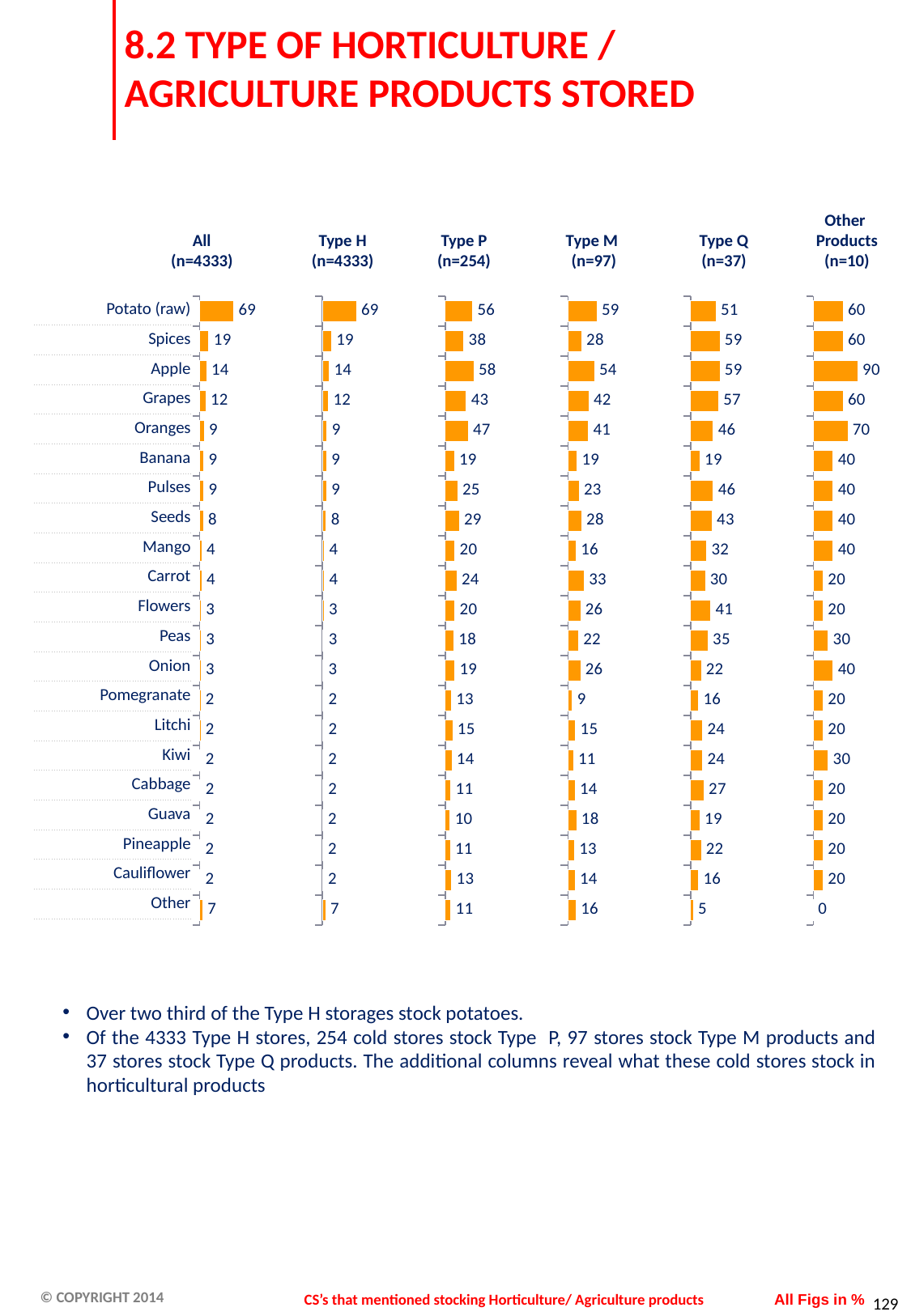
In the 'Type Q (n=37)' chart, what is the value for Pulses? 46 In the 'Type M (n=97)' chart, what is the value for Pomegranate? 9 In the 'Other Products (n=10)' chart, which product has the highest value? Apple In the 'Type P (n=254)' chart, which is larger, the value for Spices or the value for Grapes? Grapes How many separate bar charts are shown on the slide? 6 In the 'Type P (n=254)' chart, which product has the highest value? Apple What kind of chart is used for the 'All (n=4333)' column? bar chart In the 'Type Q (n=37)' chart, which category has the lowest value? Other In the 'Other Products (n=10)' chart, what is the value for Onion? 40 In the 'All (n=4333)' chart, what is the value for Potato (raw)? 69 In the 'Other Products (n=10)' chart, what is the difference between the values for Apple and Oranges? 20 How many product categories are listed in the 'All (n=4333)' chart? 21